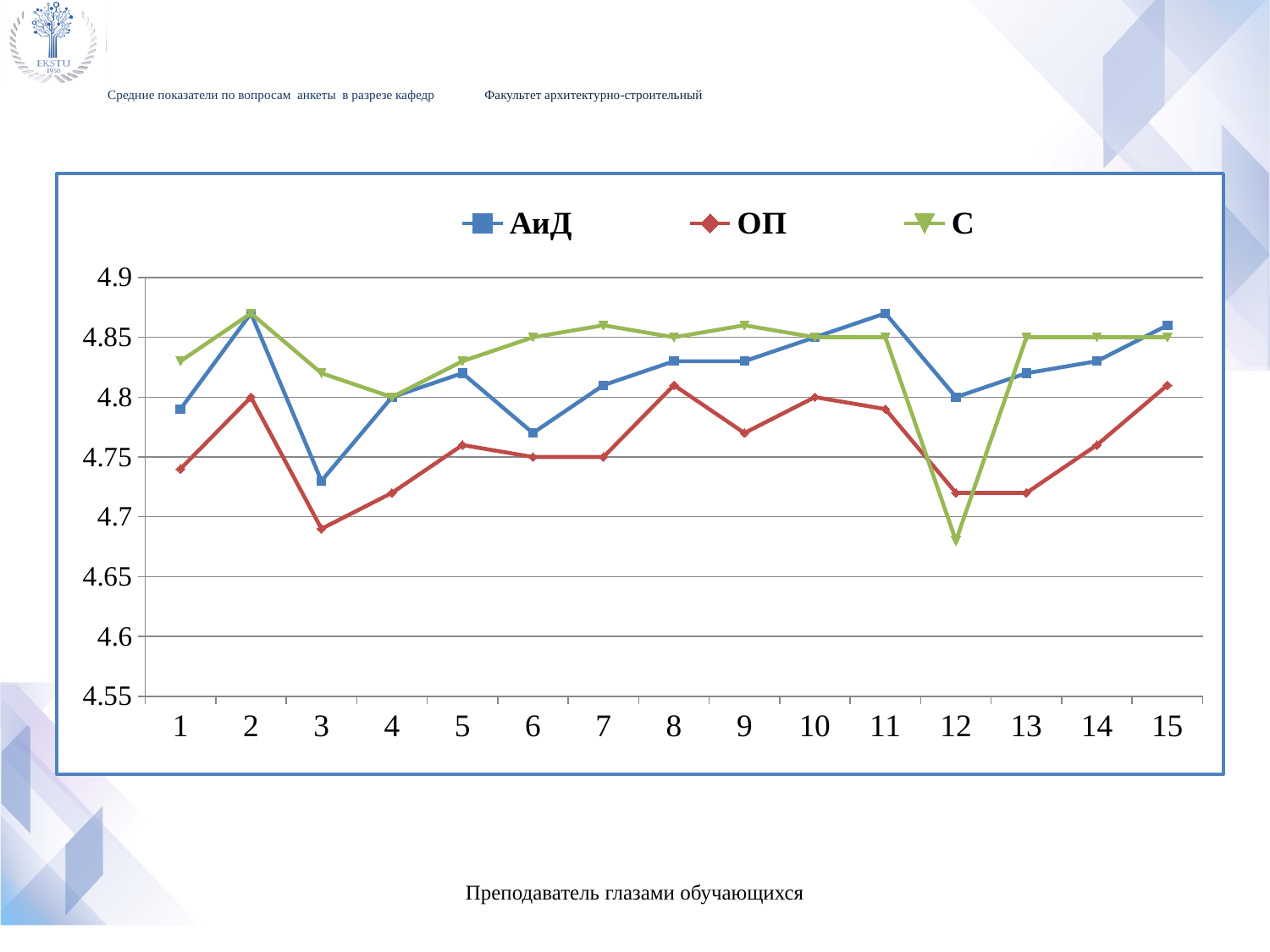
What kind of chart is shown on the slide? line chart Which series has the lowest value at point 12? С Do the values of the ОП series rise or fall from point 12 to point 15? rise At which x-axis point does the ОП series reach its lowest value? 3 How many points are plotted along the x axis for each series? 15 At point 3, which series has the larger value, АиД or ОП? АиД Is the value of the АиД series at point 3 greater or less than 4.75? less At which x-axis point does the АиД series reach its lowest value? 3 Is the value of the АиД series at point 2 greater or less than 4.85? greater How many series does the legend list? 3 Is the value of the С series at point 12 greater or less than 4.7? less